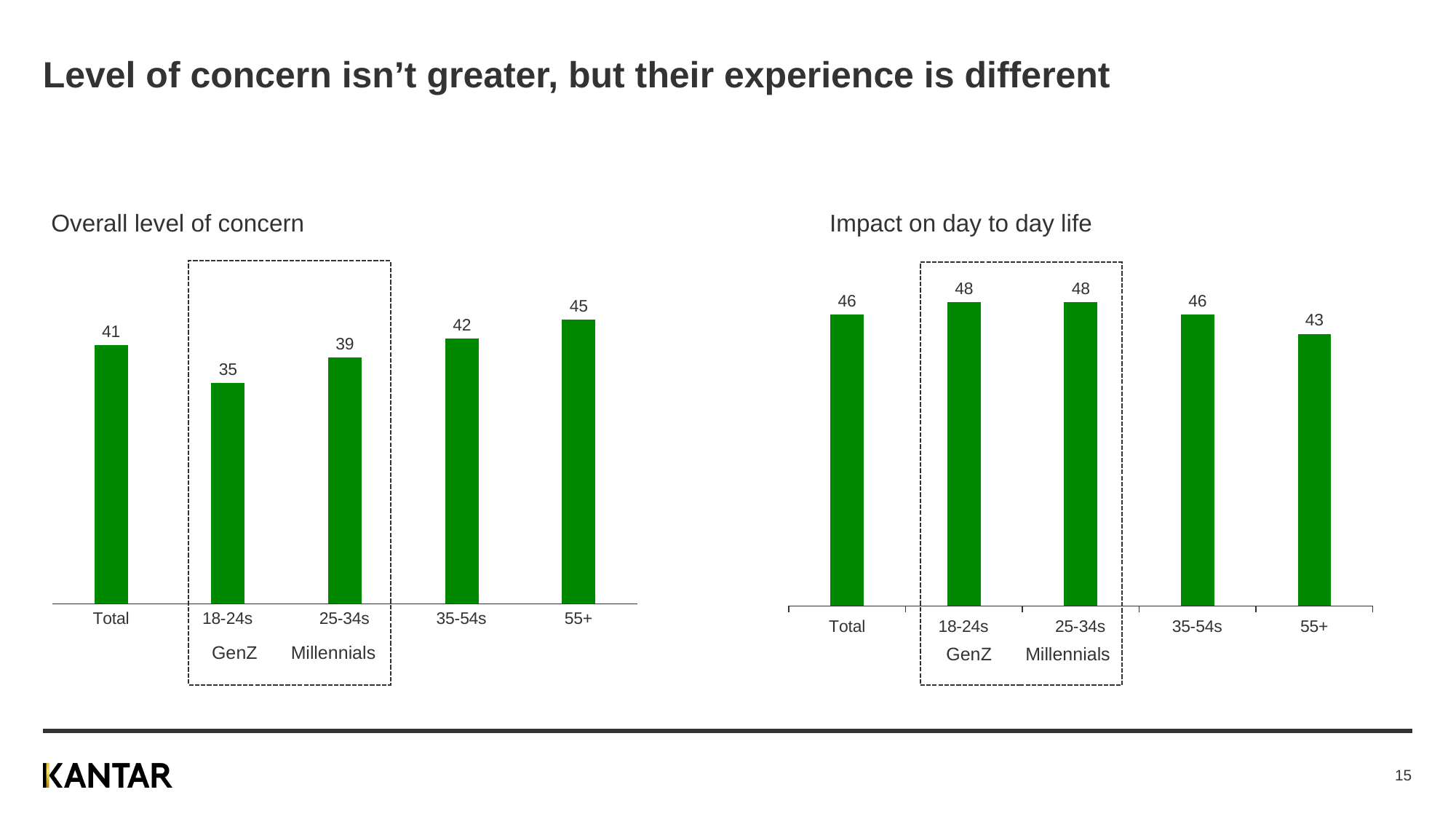
In the 'Overall level of concern' chart, which category has the lowest value? 18-24s In the 'Overall level of concern' chart, what is the difference between the values for 55+ and 18-24s? 10 In the 'Overall level of concern' chart, which is larger, the value for Total or the value for 25-34s? Total What kind of chart is the 'Impact on day to day life' chart? Bar chart In the 'Impact on day to day life' chart, what is the difference between the values for 18-24s and 55+? 5 In the 'Impact on day to day life' chart, what is the value for Total? 46 In the 'Impact on day to day life' chart, what is the value for 55+? 43 In the 'Impact on day to day life' chart, which is larger, the value for 35-54s or the value for 55+? 35-54s In the 'Overall level of concern' chart, what is the value for 18-24s? 35 In the 'Impact on day to day life' chart, which category has the lowest value? 55+ In the 'Overall level of concern' chart, which category has the highest value? 55+ How many categories are shown in the 'Overall level of concern' chart? 5